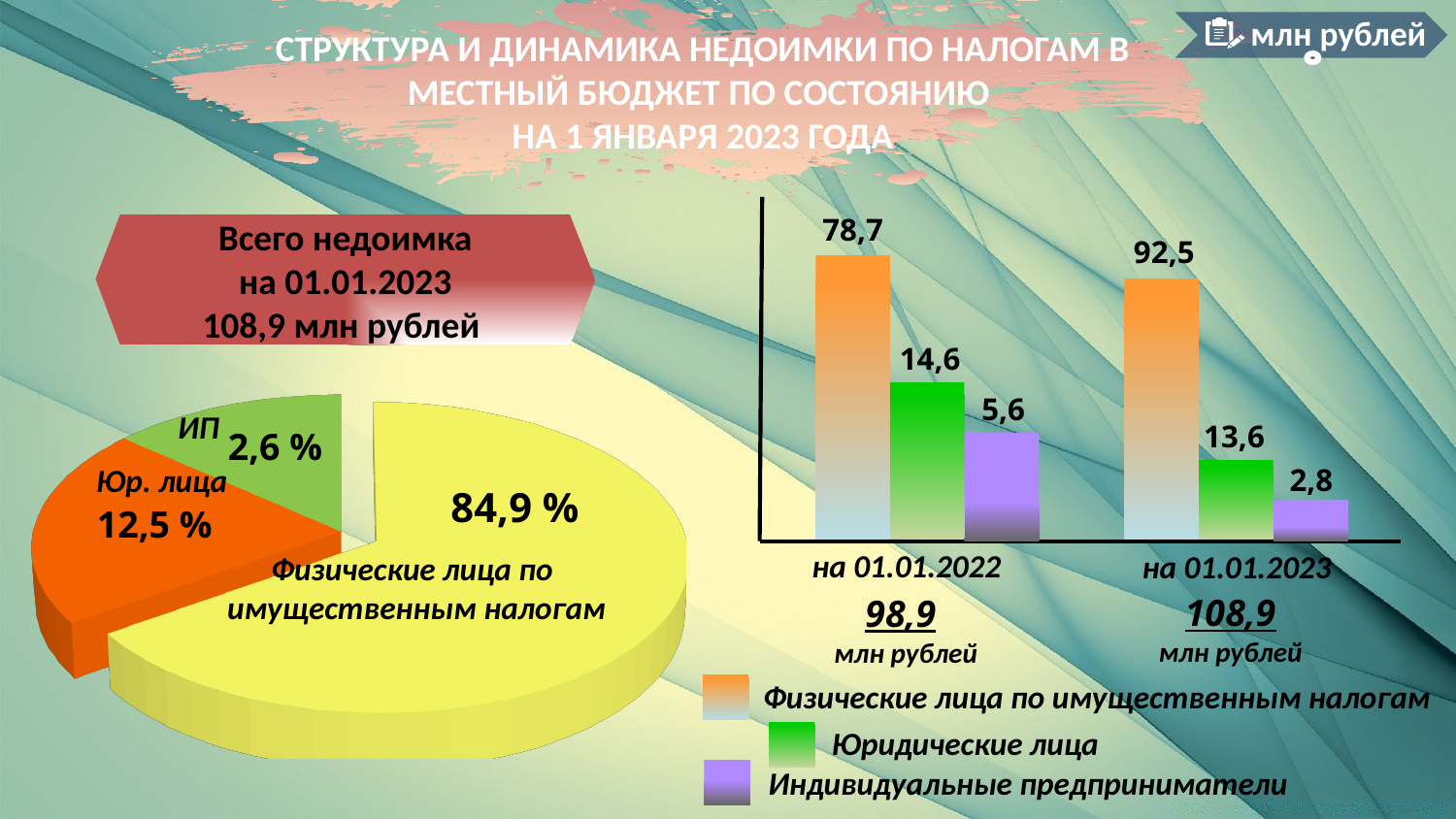
In the bar chart on the right, which is larger: "Юридические лица" на 01.01.2022 or на 01.01.2023? на 01.01.2022 What type of chart is shown on the right side of the slide? bar chart In the pie chart on the left, what share is shown for "Юр. лица"? 12,5 % In the bar chart on the right, what is the total shown for на 01.01.2023? 108,9 In the pie chart on the left, what share is shown for "Физические лица по имущественным налогам"? 84,9 % In the pie chart on the left, which slice is the smallest? ИП How many slices does the pie chart on the left have? 3 In the bar chart on the right, what is the value for "Юридические лица" на 01.01.2022? 14,6 In the bar chart on the right, by how much did the value for "Физические лица по имущественным налогам" change from 01.01.2022 to 01.01.2023? 13,8 How many series does the legend of the bar chart on the right list? 3 In the bar chart on the right, what is the value for "Индивидуальные предприниматели" на 01.01.2023? 2,8 In the bar chart on the right, what is the value for "Физические лица по имущественным налогам" на 01.01.2023? 92,5